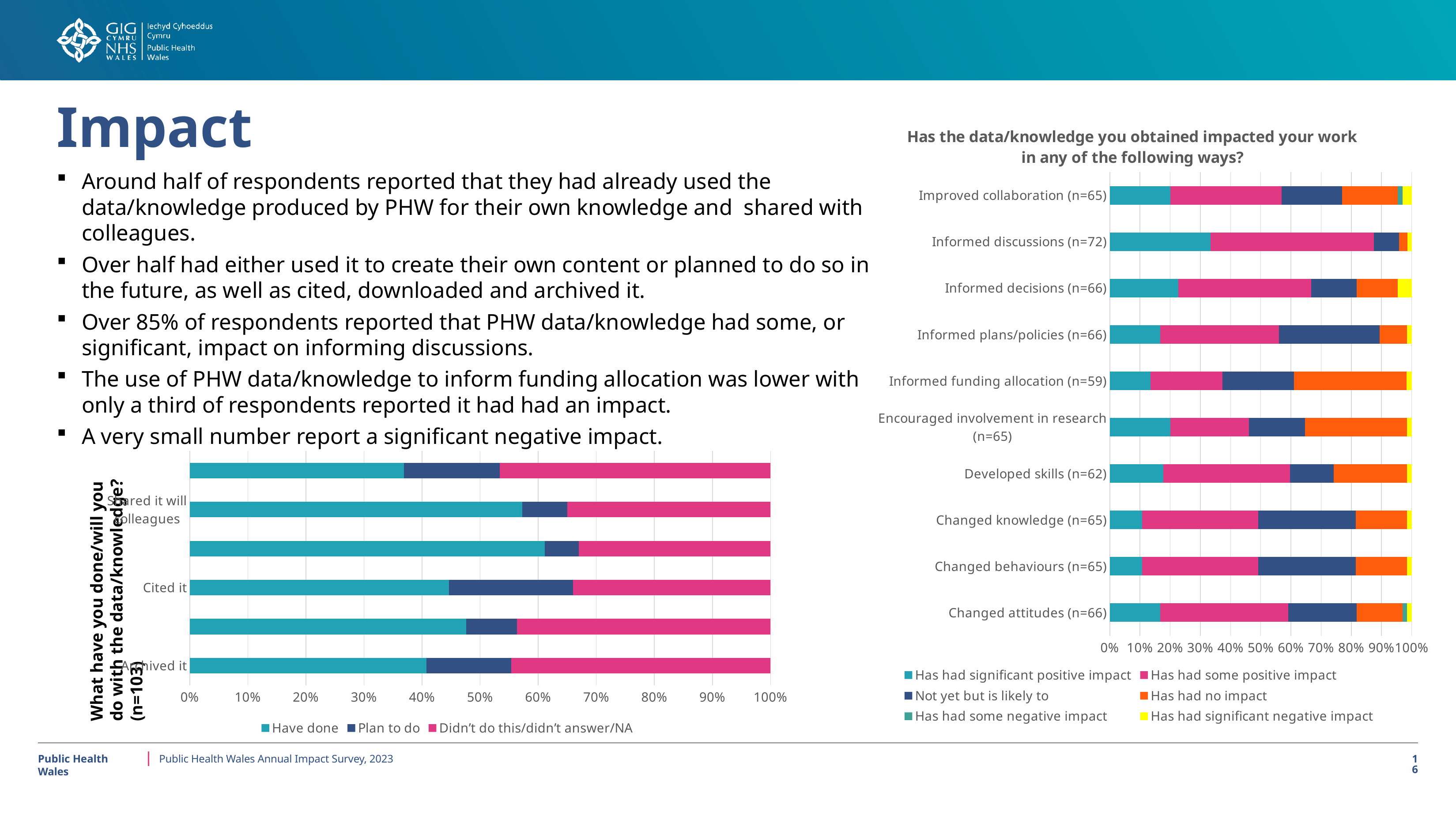
In the chart on the right, is the 'Has had significant positive impact' value for Changed knowledge (n=65) greater or less than 20%? less In the chart on the right, is the 'Has had significant positive impact' value for Informed discussions (n=72) greater or less than 20%? greater In the chart on the right, which category has the largest 'Has had significant positive impact' segment? Informed discussions (n=72) In the chart on the left, is the 'Have done' value for Cited it greater or less than 50%? less How many categories are plotted in the chart on the right? 10 What kind of chart is the chart on the right titled 'Has the data/knowledge you obtained impacted your work in any of the following ways?'? Stacked bar chart In the chart on the right, which colour represents 'Has had significant negative impact' in the legend? Yellow How many series does the legend list for the chart on the left (What have you done/will you do with the data/knowledge?)? 3 How many series does the legend list for the chart on the right? 6 In the chart on the left, which has the larger 'Have done' value: Shared it with colleagues or Archived it? Shared it with colleagues How many bars are plotted in the chart on the left (What have you done/will you do with the data/knowledge?)? 6